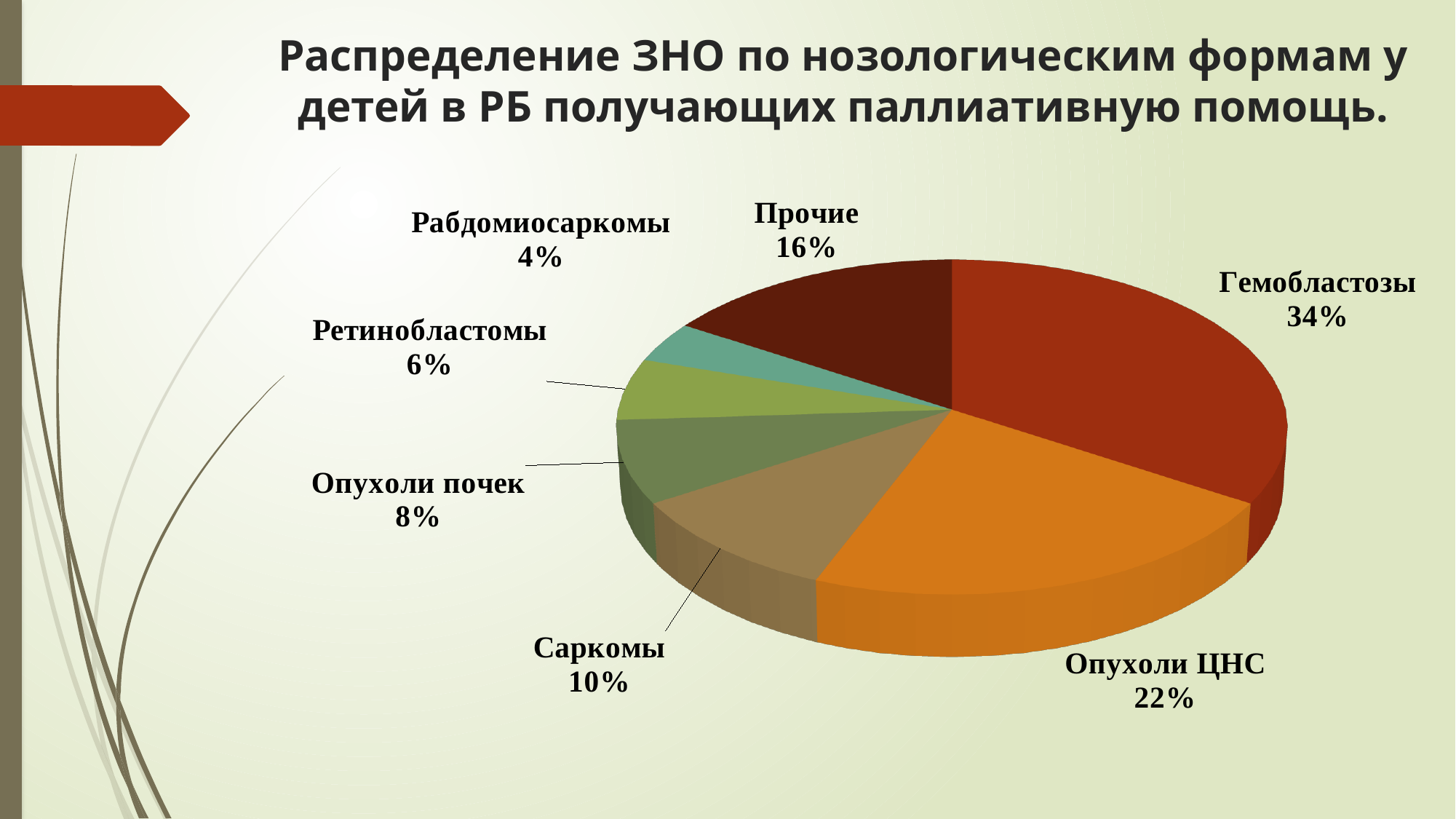
What is the difference between the shares of Прочие and Саркомы? 6% What is the difference between the shares of Гемобластозы and Опухоли ЦНС? 12% What is the value shown for Опухоли ЦНС? 22% What share of the pie does Гемобластозы have? 34% What kind of chart is shown on the slide? Pie chart What is the value shown for Прочие? 16% What is the title of the chart on the slide? Распределение ЗНО по нозологическим формам у детей в РБ получающих паллиативную помощь. Which category has the largest slice of the pie? Гемобластозы Which category has the smallest slice of the pie? Рабдомиосаркомы Which is larger, the share for Опухоли почек or the share for Ретинобластомы? Опухоли почек How many categories are shown in the pie chart? 7 What is the value shown for Саркомы? 10%